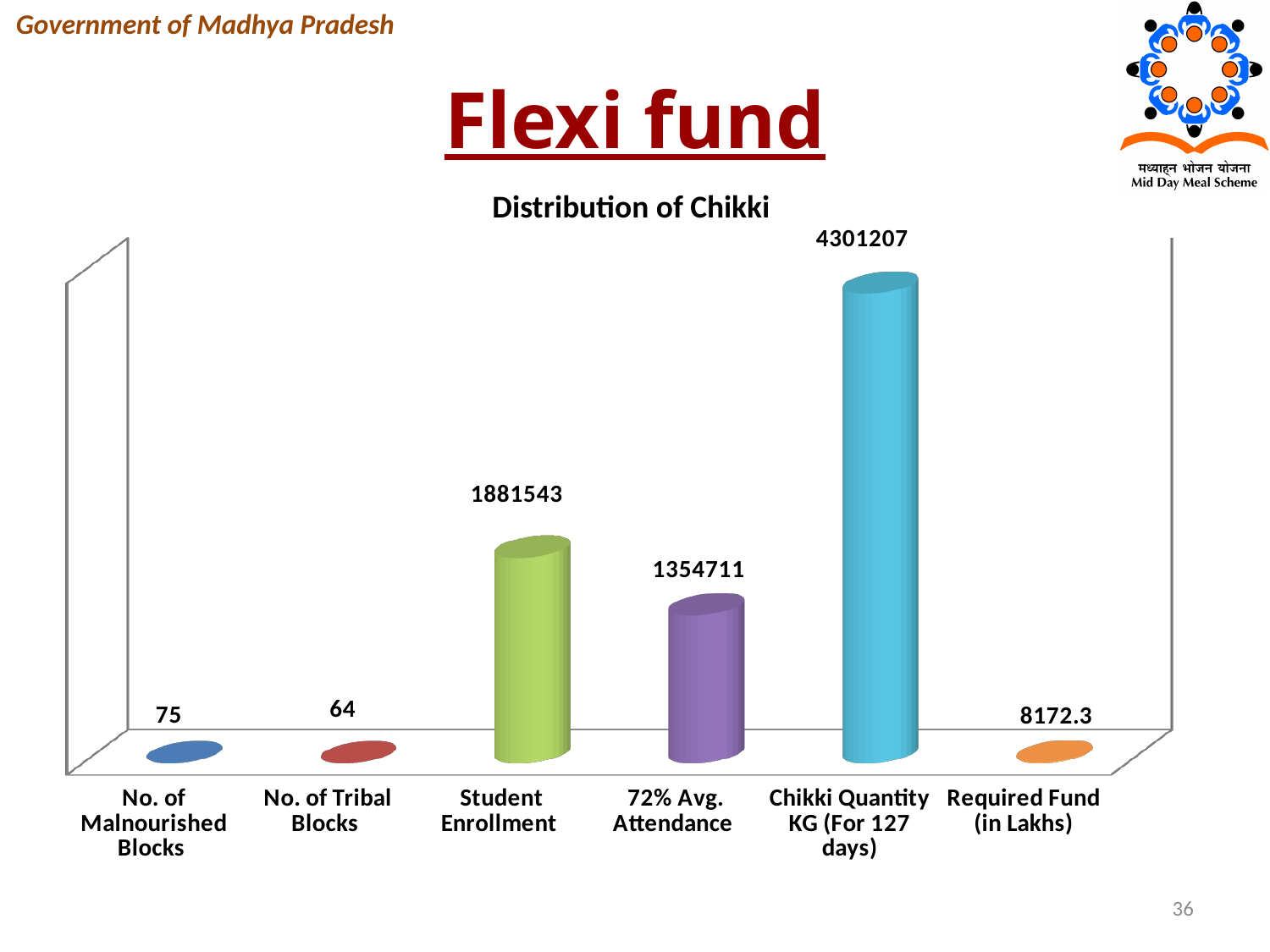
Which is larger, Student Enrollment or 72% Avg. Attendance? Student Enrollment Which category has the highest value? Chikki Quantity KG (For 127 days) What is the value for Chikki Quantity KG (For 127 days)? 4301207 What is the value for No. of Tribal Blocks? 64 What is the value for 72% Avg. Attendance? 1354711 Which category has the lowest value? No. of Tribal Blocks How many categories are shown in the chart? 6 What is the difference between No. of Malnourished Blocks and No. of Tribal Blocks? 11 What is the value for Student Enrollment? 1881543 What is the value for Required Fund (in Lakhs)? 8172.3 What is the difference between Student Enrollment and 72% Avg. Attendance? 526832 What is the title of the chart? Distribution of Chikki